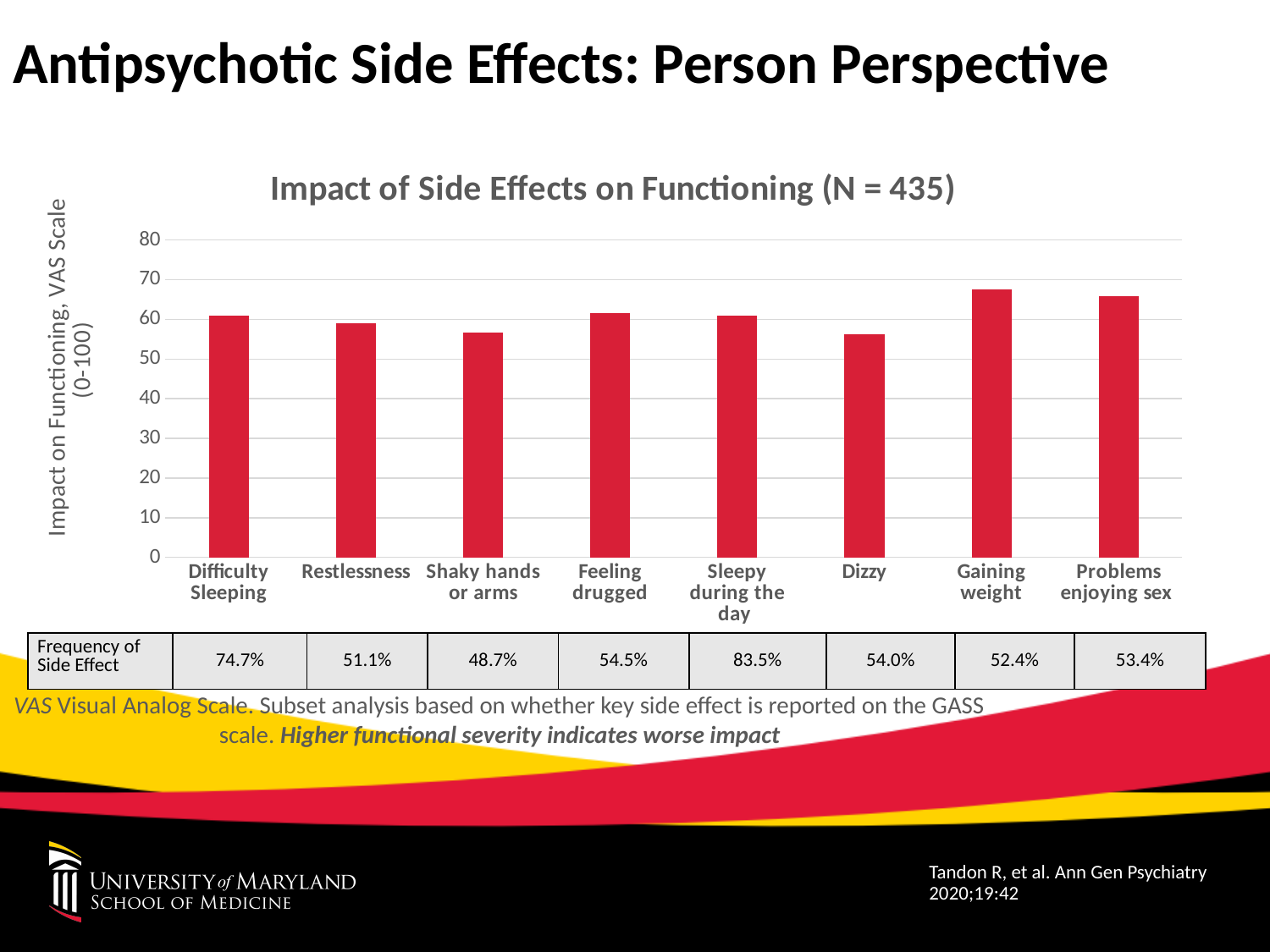
Which side effect has the highest impact on functioning in the chart? Gaining weight What is the title of the chart? Impact of Side Effects on Functioning (N = 435) Is the impact on functioning value for Shaky hands or arms greater or less than 50? greater Which has a larger impact on functioning, Restlessness or Shaky hands or arms? Restlessness How many side-effect categories are plotted in the chart? 8 What is the difference in frequency between Sleepy during the day and Difficulty Sleeping in the table under the chart? 8.8 percentage points Is the impact on functioning value for Dizzy greater or less than 60? less According to the table under the chart, which side effect has the lowest frequency? Shaky hands or arms Which has a larger impact on functioning, Gaining weight or Dizzy? Gaining weight According to the table under the chart, what is the frequency of the side effect Sleepy during the day? 83.5% Is the impact on functioning value for Gaining weight greater or less than 60? greater What type of chart is shown on the slide? Bar chart